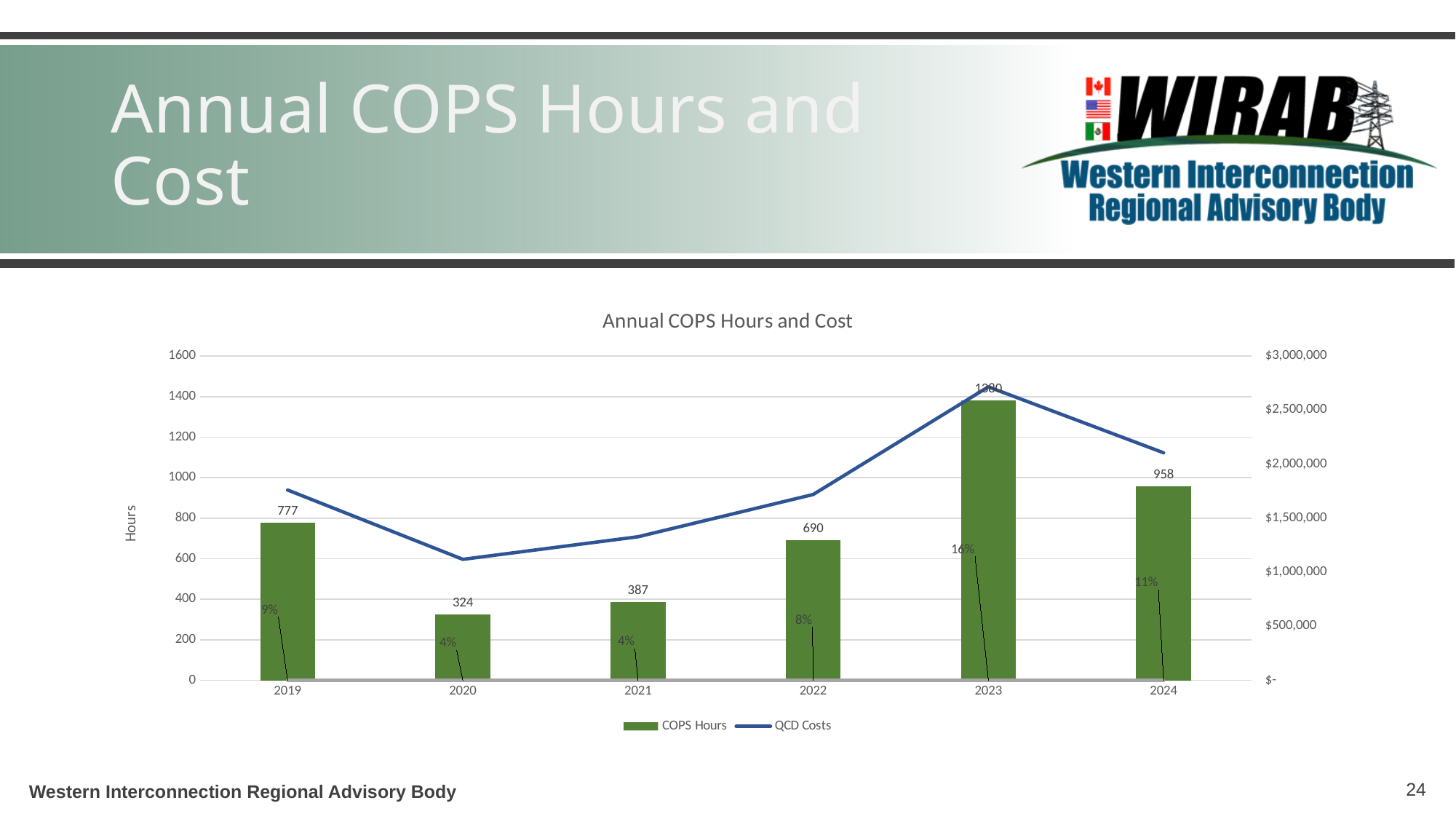
How many years are shown on the x axis? 6 What percentage label is shown on the 2023 bar? 16% Is the QCD Costs value for 2020 greater or less than $1,500,000? less How many series does the legend list? 2 Is the QCD Costs value for 2023 greater or less than $2,500,000? greater Which year has the highest COPS Hours? 2023 What is the COPS Hours value for 2024? 958 Which year has the lowest COPS Hours? 2020 What is the COPS Hours value for 2022? 690 What is the COPS Hours value for 2019? 777 Which year has more COPS Hours, 2021 or 2022? 2022 What is the difference in COPS Hours between 2019 and 2020? 453